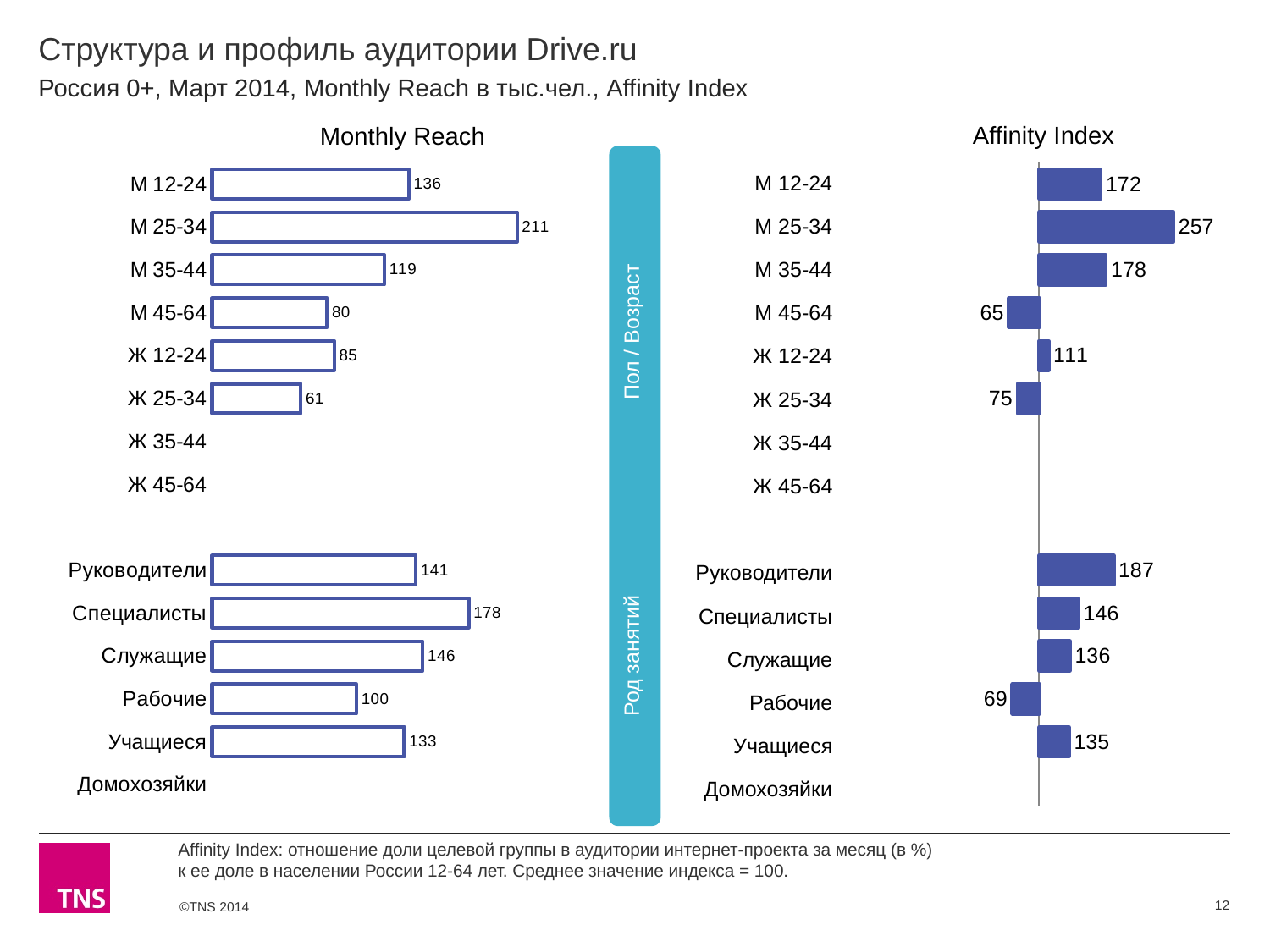
What kind of chart is the Affinity Index chart? Bar chart In the Monthly Reach chart, what is the value for Ж 25-34? 61 In the Monthly Reach chart, which is larger: Руководители or Учащиеся? Руководители In the Monthly Reach chart, which category has the highest value? М 25-34 In the Affinity Index chart, which category has the lowest value? М 45-64 In the Monthly Reach chart, what is the difference between Специалисты and Рабочие? 78 In the Monthly Reach chart, what is the value for Служащие? 146 In the Monthly Reach chart, what is the value for М 25-34? 211 In the Affinity Index chart, what is the value for Руководители? 187 In the Affinity Index chart, which is larger: М 35-44 or Ж 12-24? М 35-44 In the Affinity Index chart, what is the value for Рабочие? 69 In the Affinity Index chart, what is the difference between М 25-34 and М 12-24? 85